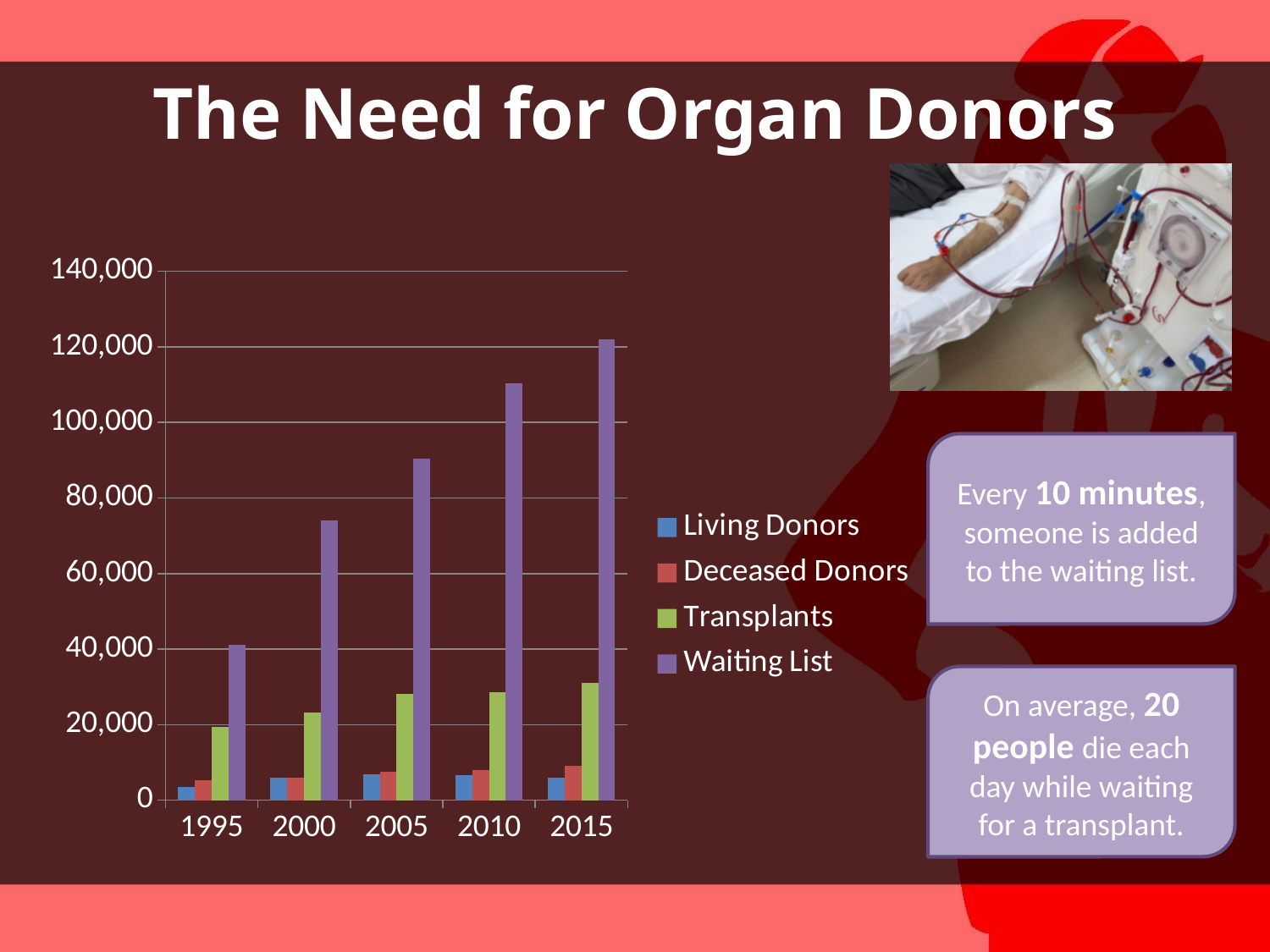
Is the Waiting List value for 2000 greater or less than 60,000? greater How many years are shown on the x axis of the chart? 5 How many series does the chart legend list? 4 What kind of chart is shown on the slide? Bar chart In which year is the Waiting List value lowest? 1995 Is the Waiting List value for 1995 greater or less than 60,000? less Is the Transplants value for 2015 greater or less than 20,000? greater In 2010, which is larger: the Waiting List value or the Transplants value? Waiting List Does the Waiting List series rise or fall from 1995 to 2015? Rise Which colour represents the Waiting List series in the chart legend? Purple In which year is the Waiting List value highest? 2015